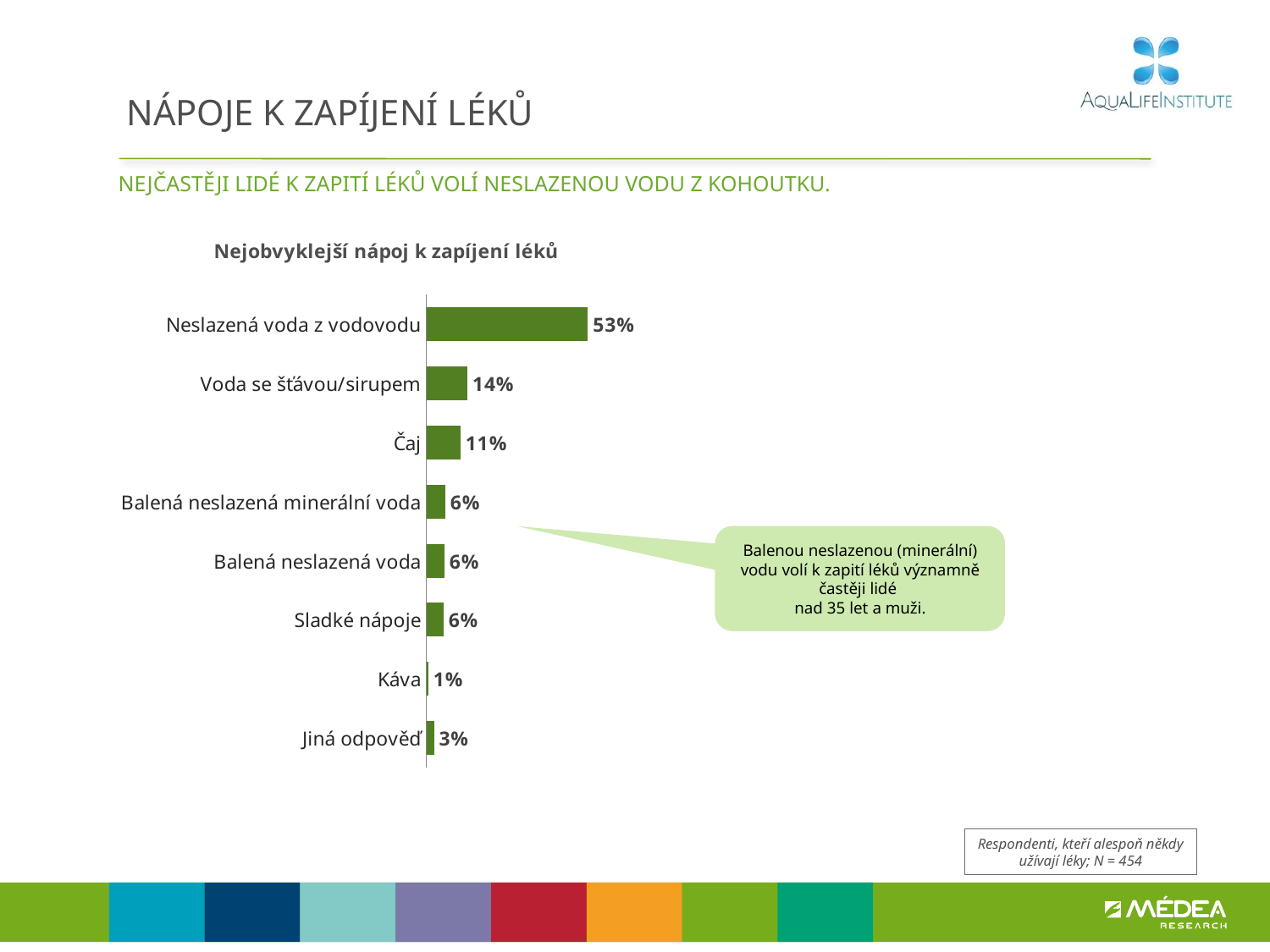
What is the value for Neslazená voda z vodovodu? 53% What is the difference between the values for Neslazená voda z vodovodu and Voda se šťávou/sirupem? 39% What is the title of the chart? Nejobvyklejší nápoj k zapíjení léků What is the value for Káva? 1% What kind of chart is shown on the slide? Bar chart Which category has the lowest value? Káva How many categories are shown in the chart? 8 What is the value for Čaj? 11% What is the value for Voda se šťávou/sirupem? 14% What is the difference between the values for Čaj and Jiná odpověď? 8% Which is larger, the value for Voda se šťávou/sirupem or the value for Čaj? Voda se šťávou/sirupem Which category has the highest value? Neslazená voda z vodovodu